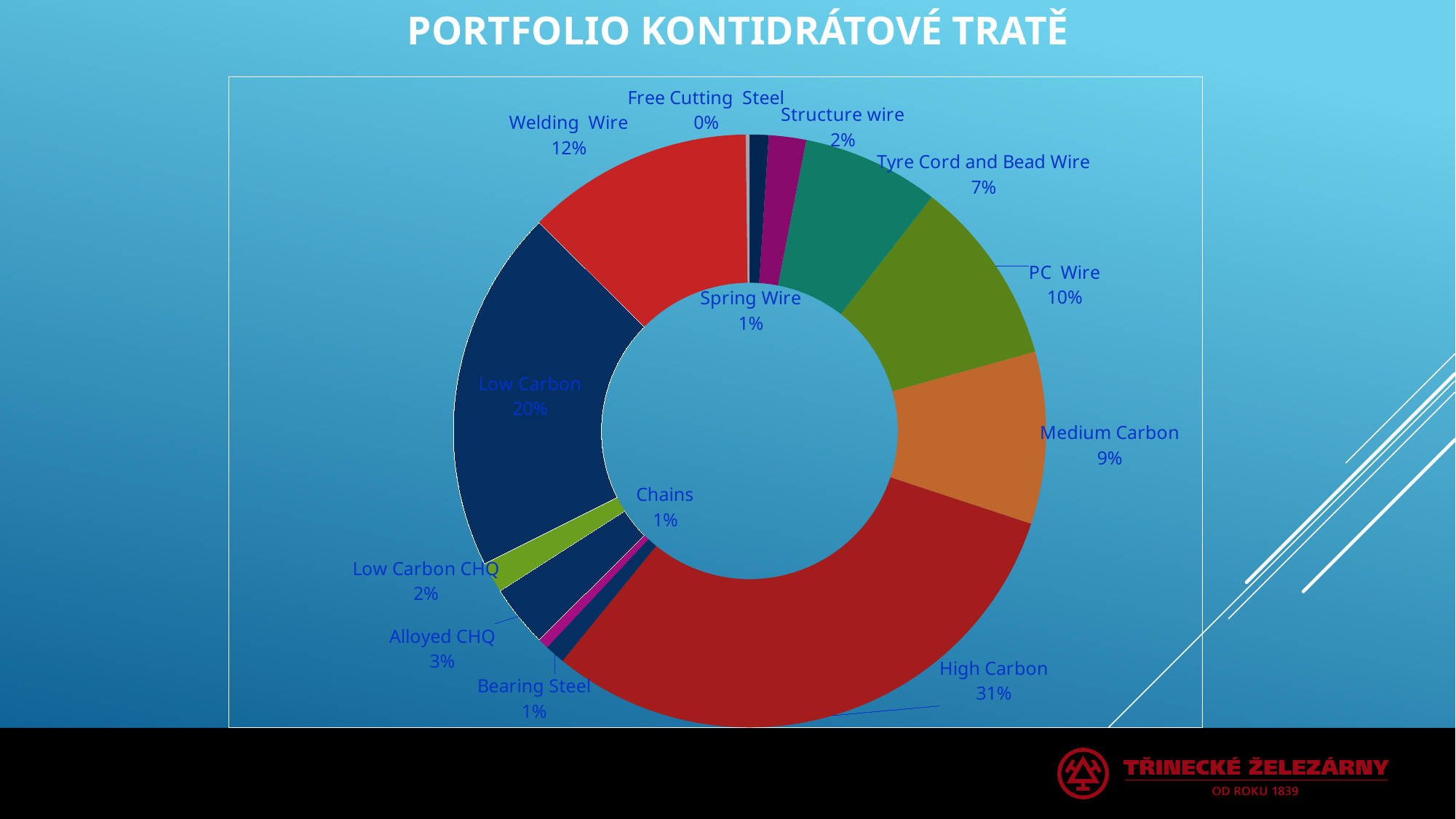
Which category has the smallest share, labelled 0%? Free Cutting Steel What percentage is shown for Low Carbon? 20% What share of the portfolio does High Carbon represent? 31% What kind of chart is shown on the slide? doughnut chart Which category has the largest share of the portfolio? High Carbon What is the difference in percentage points between High Carbon and Low Carbon? 11 What is the title of the slide? PORTFOLIO KONTIDRÁTOVÉ TRATĚ How many categories are shown in the chart? 13 Which has a larger share, Alloyed CHQ or Low Carbon CHQ? Alloyed CHQ What percentage is shown for Tyre Cord and Bead Wire? 7% Which has a larger share, PC Wire or Medium Carbon? PC Wire What is the value labelled for Welding Wire? 12%